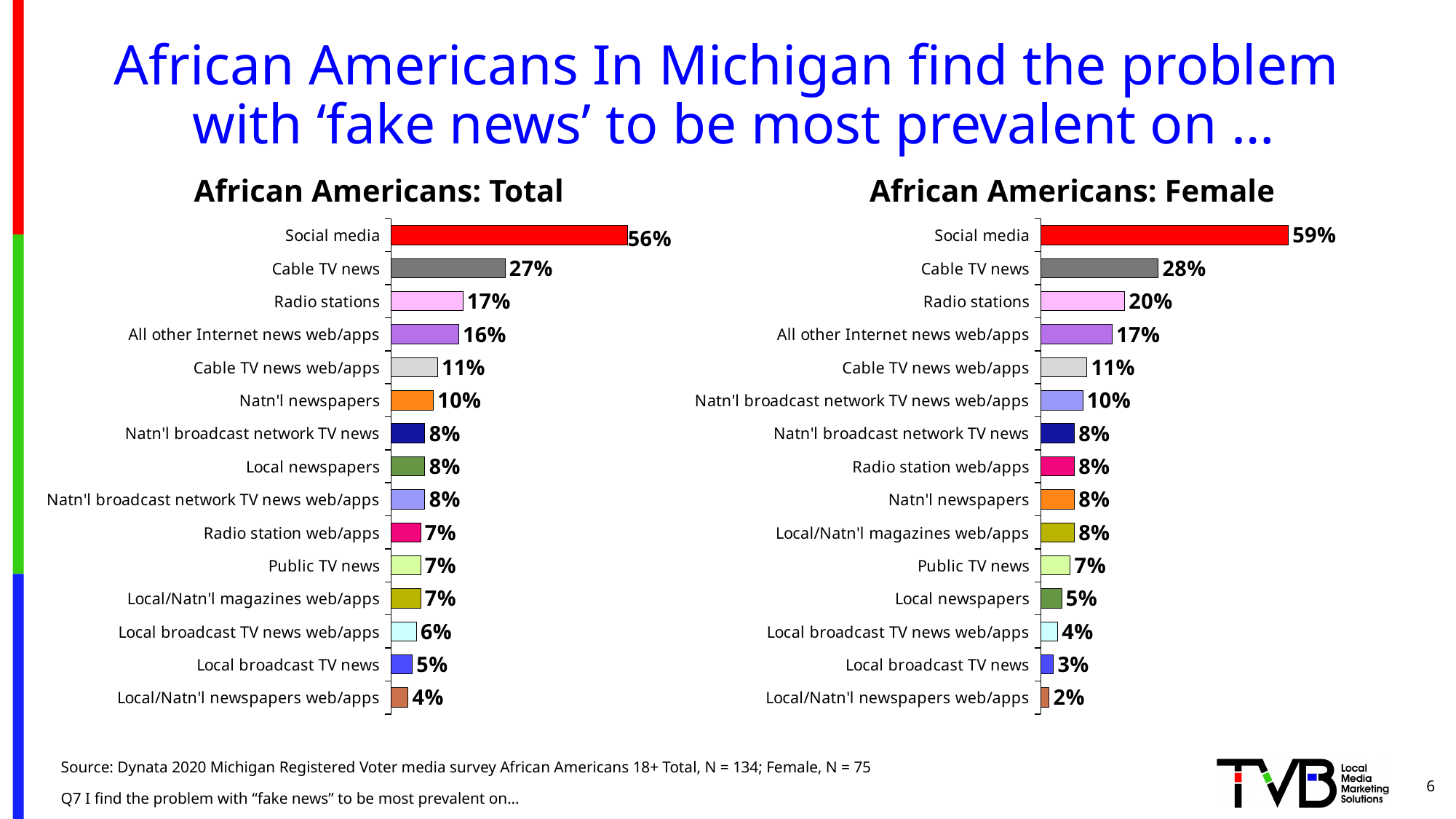
In the 'African Americans: Total' chart, what is the value for Social media? 56% In the 'African Americans: Total' chart, which category has the lowest value? Local/Natn'l newspapers web/apps Which is larger: Social media in the 'African Americans: Total' chart or Social media in the 'African Americans: Female' chart? African Americans: Female In the 'African Americans: Female' chart, which category has the highest value? Social media In the 'African Americans: Total' chart, what is the difference between Cable TV news and Radio stations? 10% In the 'African Americans: Total' chart, what is the value for Cable TV news web/apps? 11% In the 'African Americans: Female' chart, which is larger: Local newspapers or Public TV news? Public TV news In the 'African Americans: Female' chart, what is the value for Radio stations? 20% What kind of chart is the 'African Americans: Female' chart? Bar chart In the 'African Americans: Female' chart, what is the value for Local broadcast TV news? 3% In the 'African Americans: Female' chart, what is the difference between Social media and Cable TV news? 31% How many categories are shown in the 'African Americans: Total' chart? 15